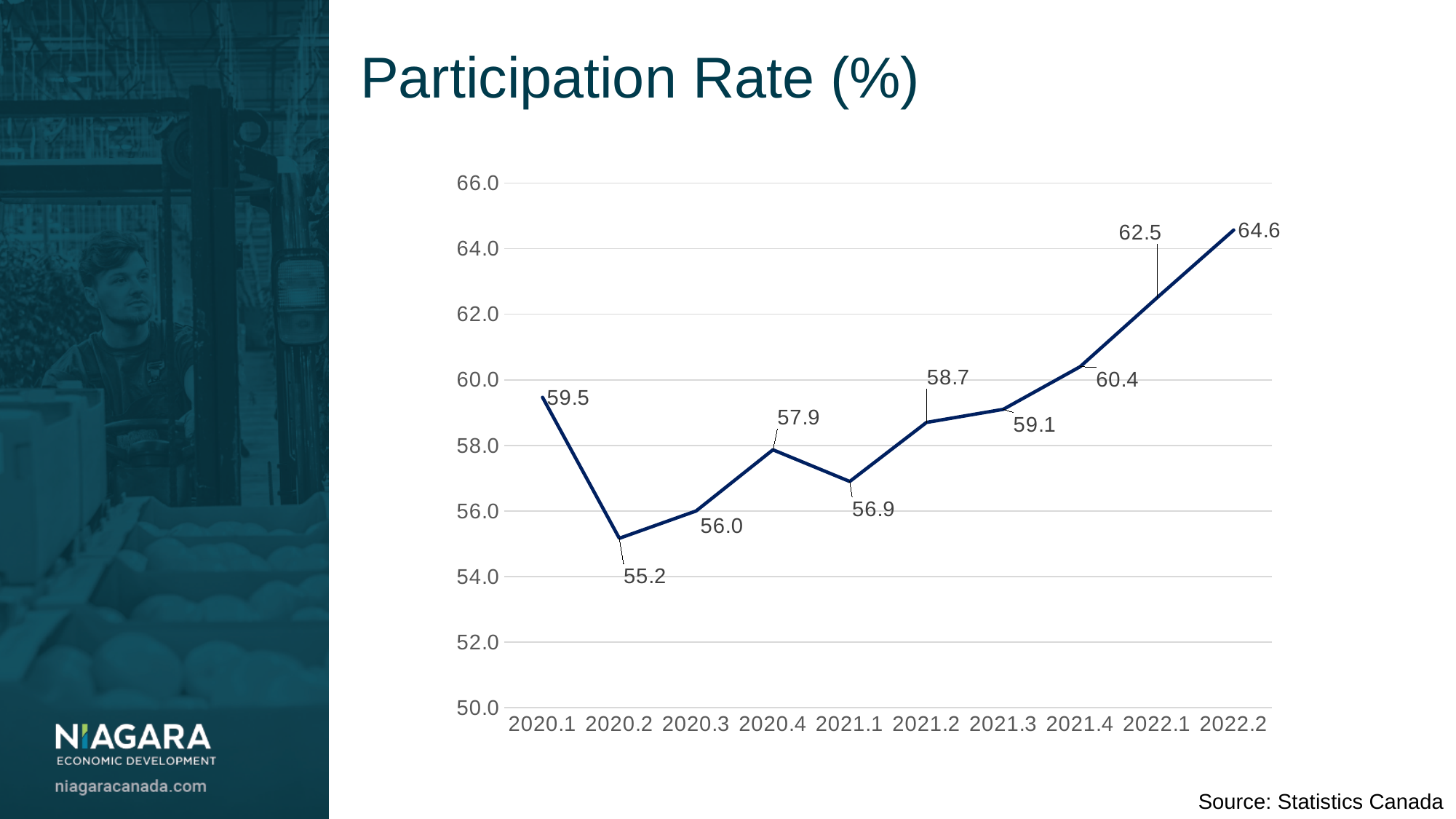
What kind of chart is shown on the slide? line chart What is the participation rate for 2022.1? 62.5 Does the participation rate rise or fall from 2021.1 to 2022.2? rise Which is larger, the participation rate in 2020.1 or in 2021.3? 2020.1 Which period has the lowest participation rate? 2020.2 Is the participation rate for 2021.4 greater or less than 60.0? greater How many periods are plotted on the chart? 10 What is the difference between the participation rate in 2022.2 and in 2020.2? 9.4 What is the difference between the participation rate in 2020.4 and in 2021.1? 1.0 What is the participation rate for 2021.1? 56.9 What is the participation rate for 2020.1? 59.5 Which period has the highest participation rate? 2022.2